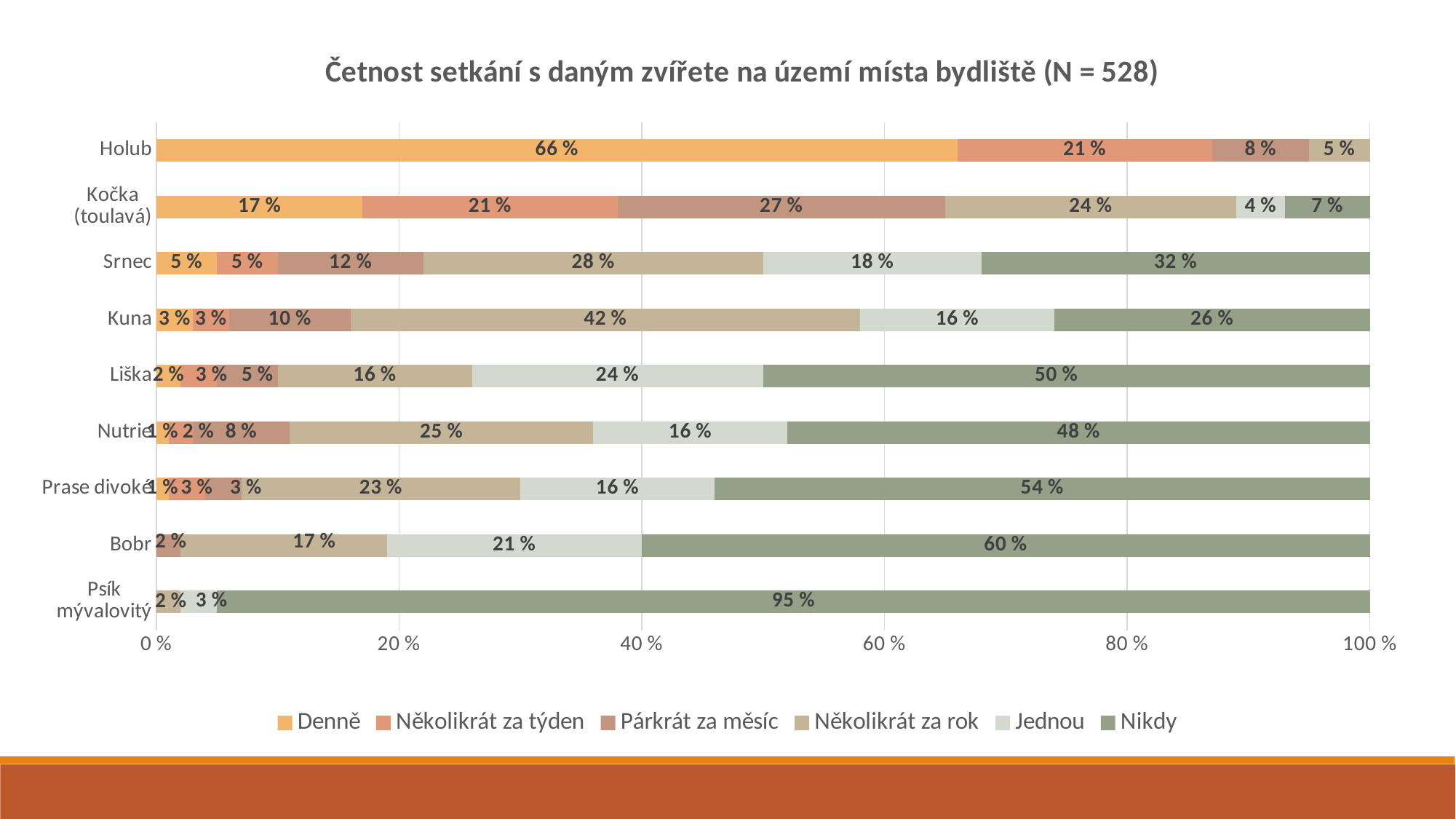
What is the 'Nikdy' value for Psík mývalovitý? 95 % Which has the larger 'Nikdy' value, Bobr or Prase divoké? Bobr What is the 'Párkrát za měsíc' value for Kočka (toulavá)? 27 % What is the 'Několikrát za rok' value for Kuna? 42 % What is the difference between the 'Nikdy' values for Srnec and Kuna? 6 percentage points How many series does the legend list? 6 What is the 'Denně' value for Holub? 66 % What is the title of the chart? Četnost setkání s daným zvířete na území místa bydliště (N = 528) Which animal has the highest 'Denně' share? Holub Which animal has the highest 'Nikdy' share? Psík mývalovitý What kind of chart is shown on the slide? Stacked bar chart How many animal categories are plotted on the chart? 9